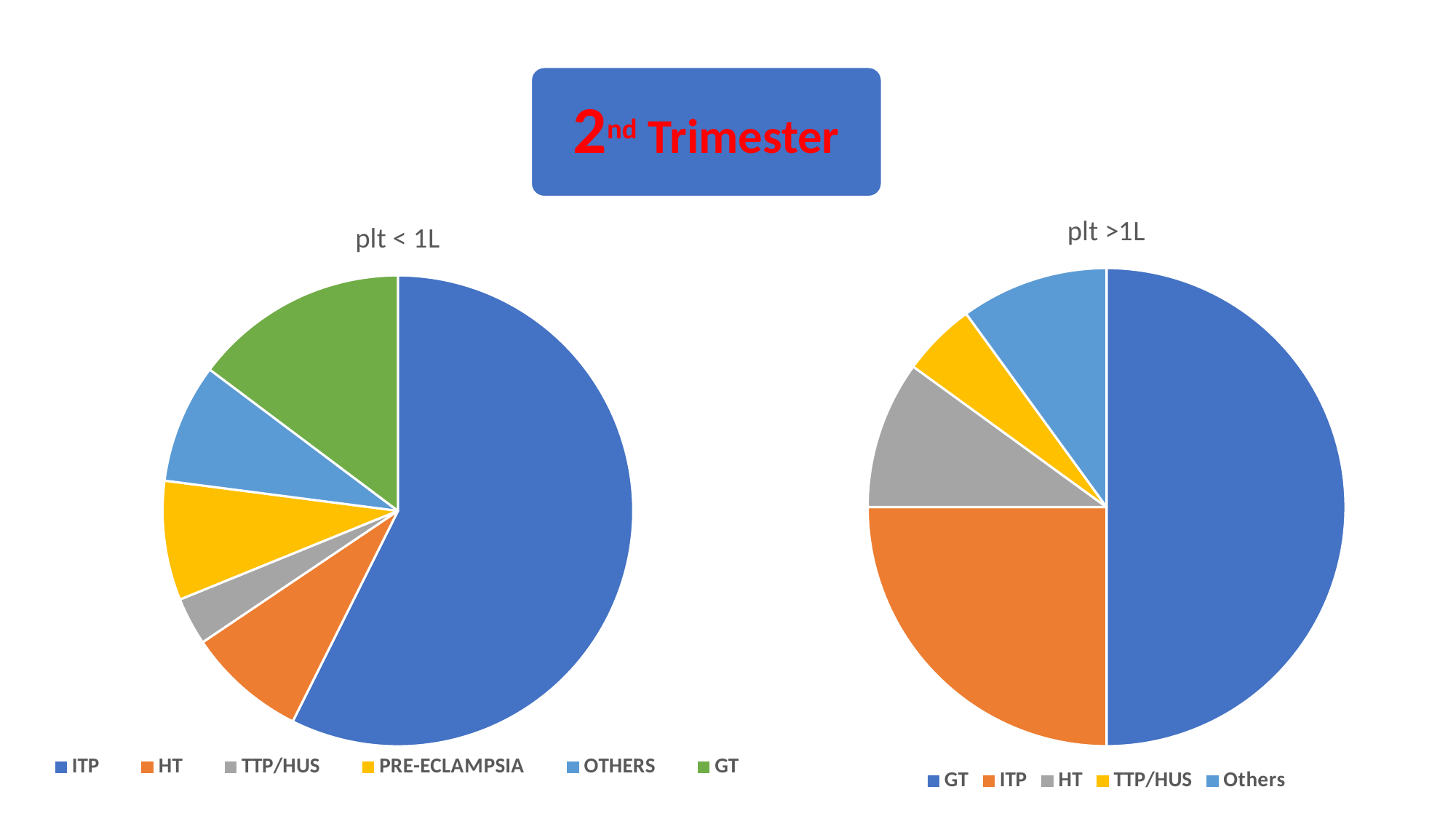
What is the title of the pie chart on the left of the slide? plt < 1L In the chart titled "plt < 1L", which slice is larger, GT or TTP/HUS? GT In the chart titled "plt >1L", which category has the largest slice? GT In the chart titled "plt < 1L", which category has the largest slice? ITP In the chart titled "plt >1L", which category has the smallest slice? TTP/HUS In the chart titled "plt < 1L", which category has the smallest slice? TTP/HUS In the chart titled "plt >1L", how many categories does the legend list? 5 In the chart titled "plt < 1L", how many categories does the legend list? 6 What kind of chart is the chart titled "plt < 1L"? pie chart In the chart titled "plt >1L", which slice is larger, ITP or HT? ITP What kind of chart is the chart titled "plt >1L"? pie chart In the chart titled "plt >1L", which colour represents the GT slice? blue